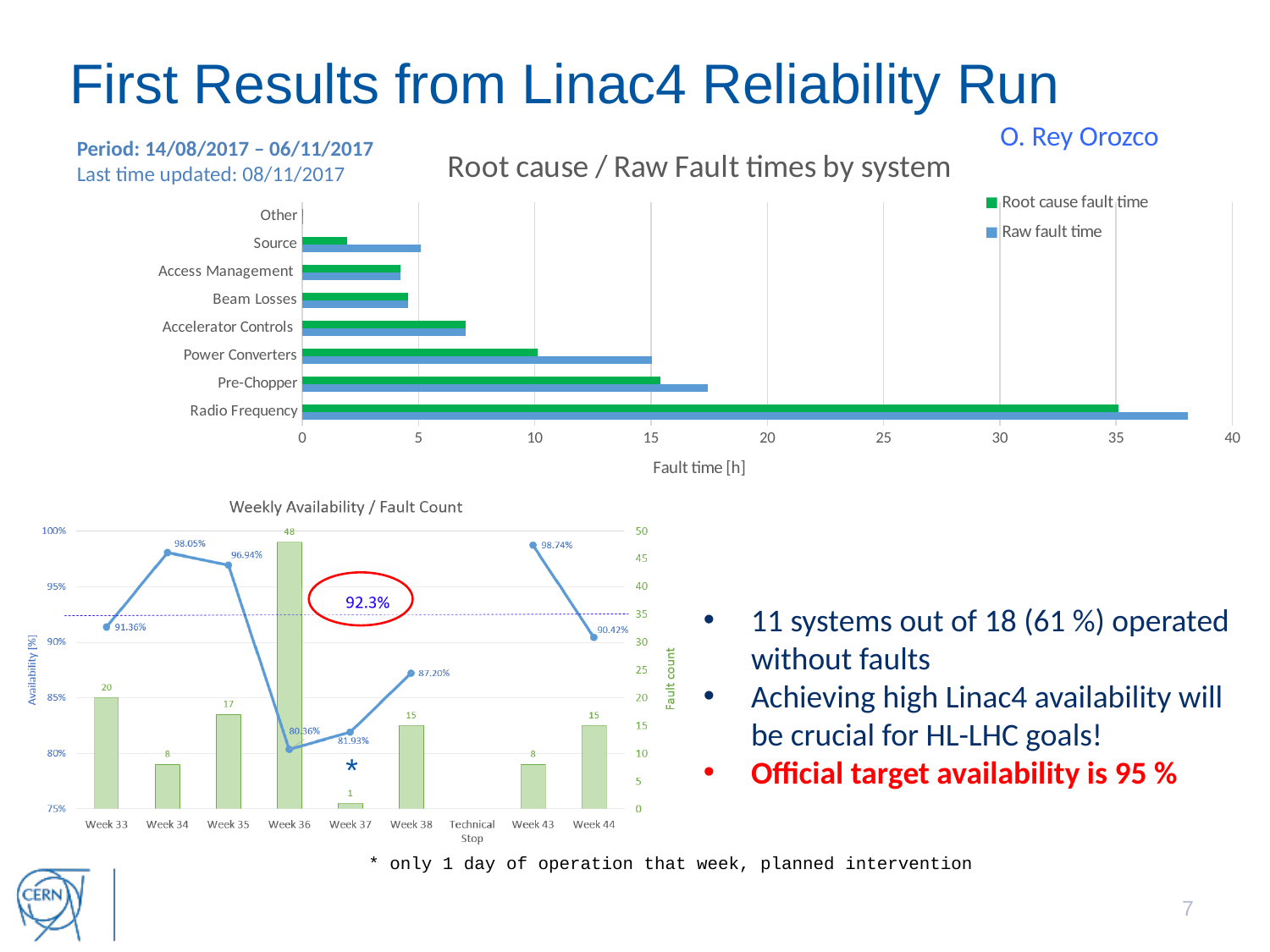
In the 'Root cause / Raw Fault times by system' chart, is the raw fault time for Radio Frequency greater or less than 35? greater In the 'Weekly Availability / Fault Count' chart, what is the fault count for Week 36? 48 In the 'Weekly Availability / Fault Count' chart, what is the availability for Week 34? 98.05% In the 'Root cause / Raw Fault times by system' chart, how many series does the legend list? 2 In the 'Root cause / Raw Fault times by system' chart, how many systems are listed on the vertical axis? 8 In the 'Weekly Availability / Fault Count' chart, which week has the lowest availability? Week 36 In the 'Root cause / Raw Fault times by system' chart, which system has the highest raw fault time? Radio Frequency In the 'Root cause / Raw Fault times by system' chart, is the root cause fault time for Source greater or less than 5? less In the 'Root cause / Raw Fault times by system' chart, what kind of chart is it? bar chart In the 'Weekly Availability / Fault Count' chart, what is the difference in fault count between Week 33 and Week 34? 12 In the 'Weekly Availability / Fault Count' chart, which has the higher availability, Week 35 or Week 38? Week 35 In the 'Weekly Availability / Fault Count' chart, which week has the lowest fault count? Week 37